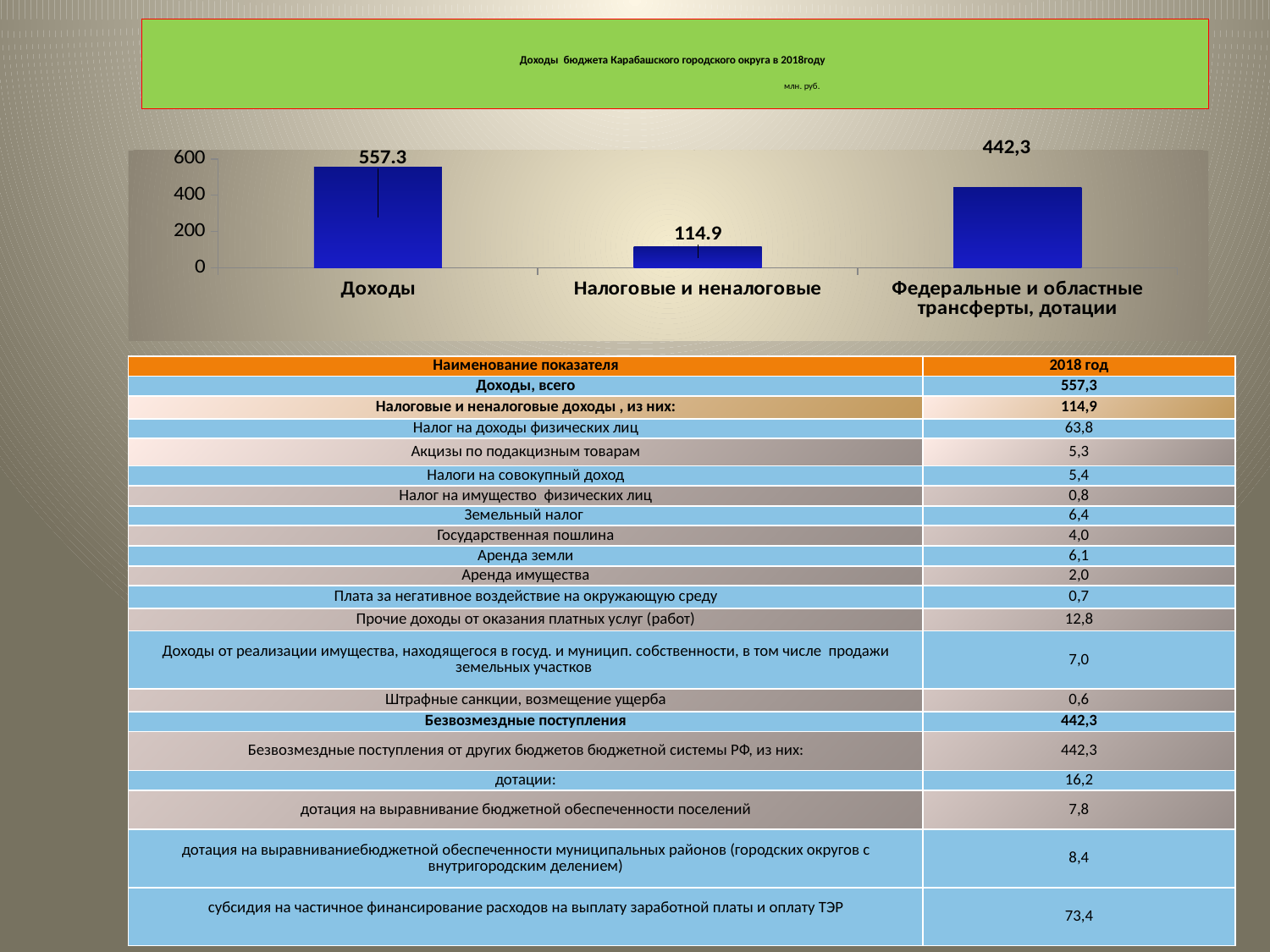
What unit of measurement is stated under the chart title? млн. руб. What is the value of the bar for Доходы? 557.3 Which category has the highest bar? Доходы What is the difference between the values for Федеральные и областные трансферты, дотации and Налоговые и неналоговые? 327.4 What is the difference between the values for Доходы and Налоговые и неналоговые? 442.4 How many categories are shown on the chart? 3 Is the value for Налоговые и неналоговые greater or less than 200? less Which category has the lowest bar? Налоговые и неналоговые What is the value of the bar for Налоговые и неналоговые? 114.9 Which is larger, the bar for Налоговые и неналоговые or the bar for Федеральные и областные трансферты, дотации? Федеральные и областные трансферты, дотации What is the value of the bar for Федеральные и областные трансферты, дотации? 442,3 What kind of chart is shown on the slide? bar chart